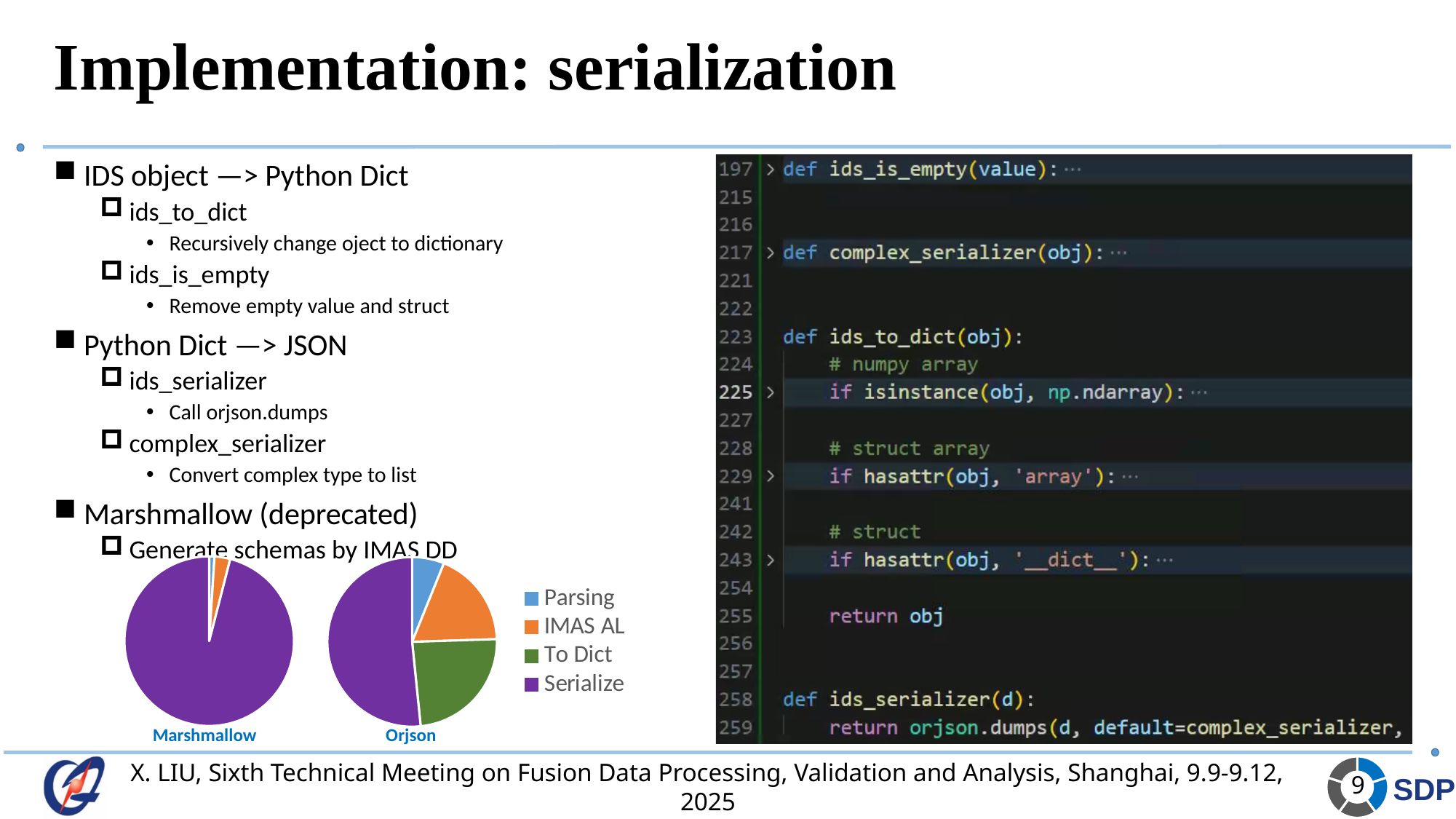
In the Marshmallow pie chart, which slice is larger, Serialize or IMAS AL? Serialize Which of the two pie charts has the larger Parsing slice, Marshmallow or Orjson? Orjson What are the titles of the two pie charts on the slide? Marshmallow and Orjson How many categories does the legend shared by the two pie charts list? 4 In the Orjson pie chart, which category has the smallest slice? Parsing In the Orjson pie chart, which slice is larger, Serialize or Parsing? Serialize What kind of chart is the Marshmallow chart? pie chart In the Marshmallow pie chart, which category has the largest slice? Serialize What kind of chart is the Orjson chart? pie chart What colour represents the Serialize category in the pie charts? purple In the Orjson pie chart, which category has the largest slice? Serialize